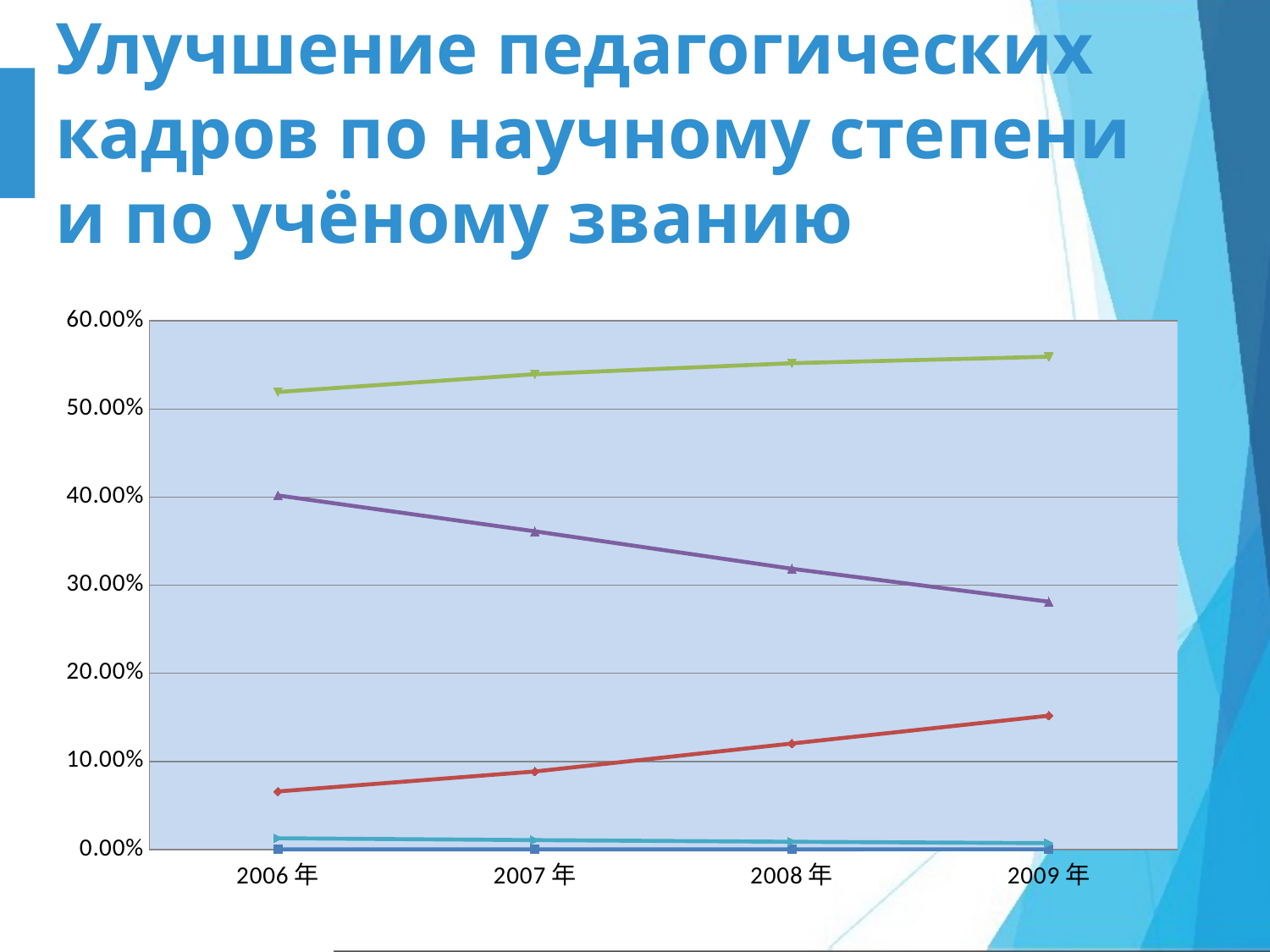
What kind of chart is shown on the slide? line chart Does the green line rise or fall from 2006年 to 2009年? rise Which line is higher in 2009年, the green line or the purple line? the green line In which year does the purple line reach its highest value? 2006年 How many lines are plotted on the chart? 5 Is the value of the red line for 2006年 greater or less than 10.00%? less Does the purple line rise or fall from 2006年 to 2009年? fall Is the value of the purple line for 2009年 greater or less than 30.00%? less Is the value of the red line for 2009年 greater or less than 10.00%? greater How many years are shown on the x axis of the chart? 4 Does the red line rise or fall from 2006年 to 2009年? rise